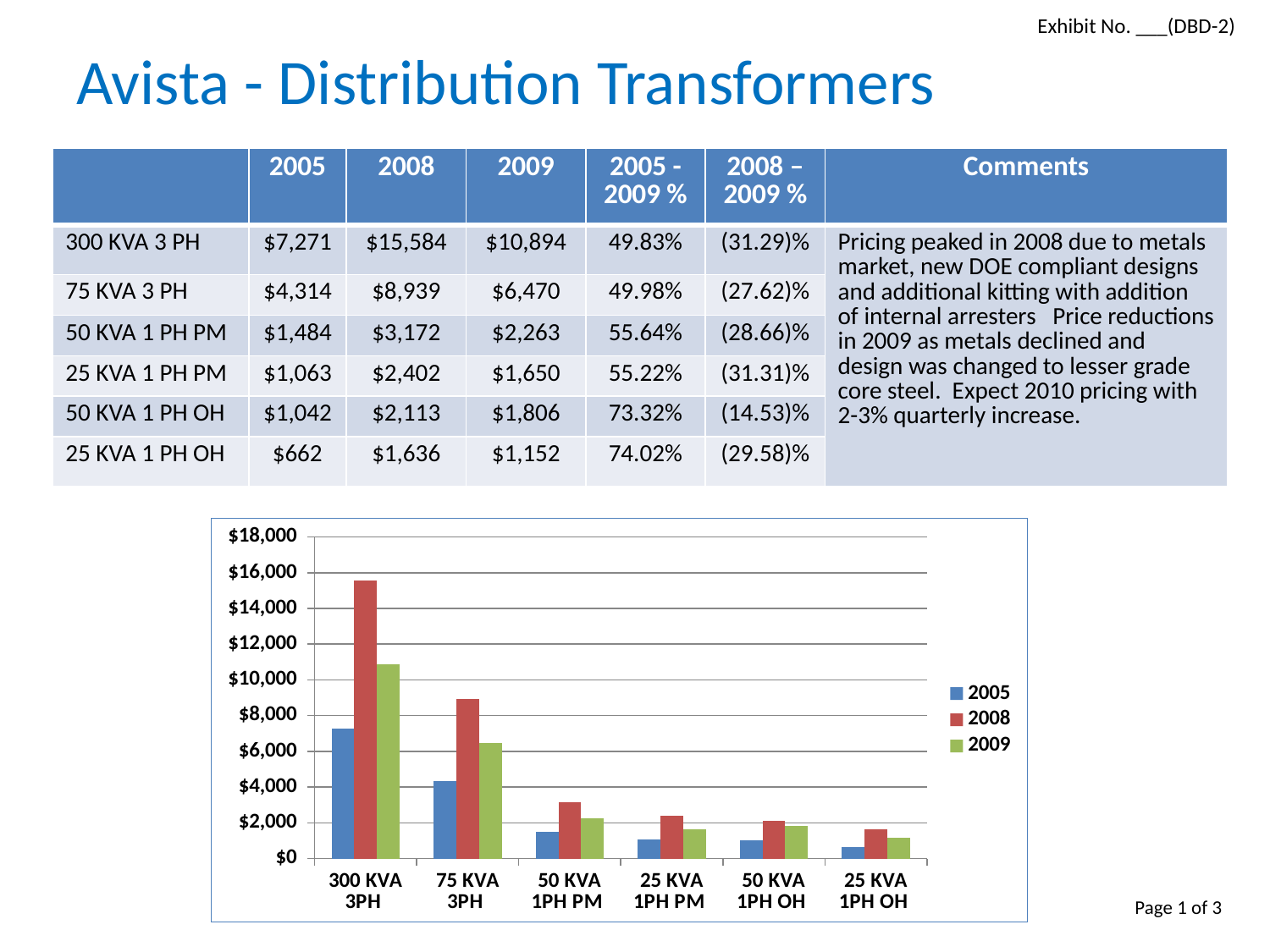
What kind of chart is shown on the slide? bar chart How many transformer categories are plotted along the x axis of the chart? 6 Do the 2005 bars rise or fall moving from left to right across the categories? fall Is the 2009 bar for 300 KVA 3PH greater or less than $10,000? greater For 50 KVA 1PH PM, which bar is taller, 2008 or 2009? 2008 Is the 2005 bar for 75 KVA 3PH greater or less than $6,000? less Which category has the tallest bar in the chart? 300 KVA 3PH Which series has the tallest bar for 300 KVA 3PH in the chart? 2008 How many series does the chart legend list? 3 What colour are the 2008 bars in the chart? red Is the 2008 bar for 300 KVA 3PH greater or less than $14,000? greater Which category has the shortest 2005 bar in the chart? 25 KVA 1PH OH